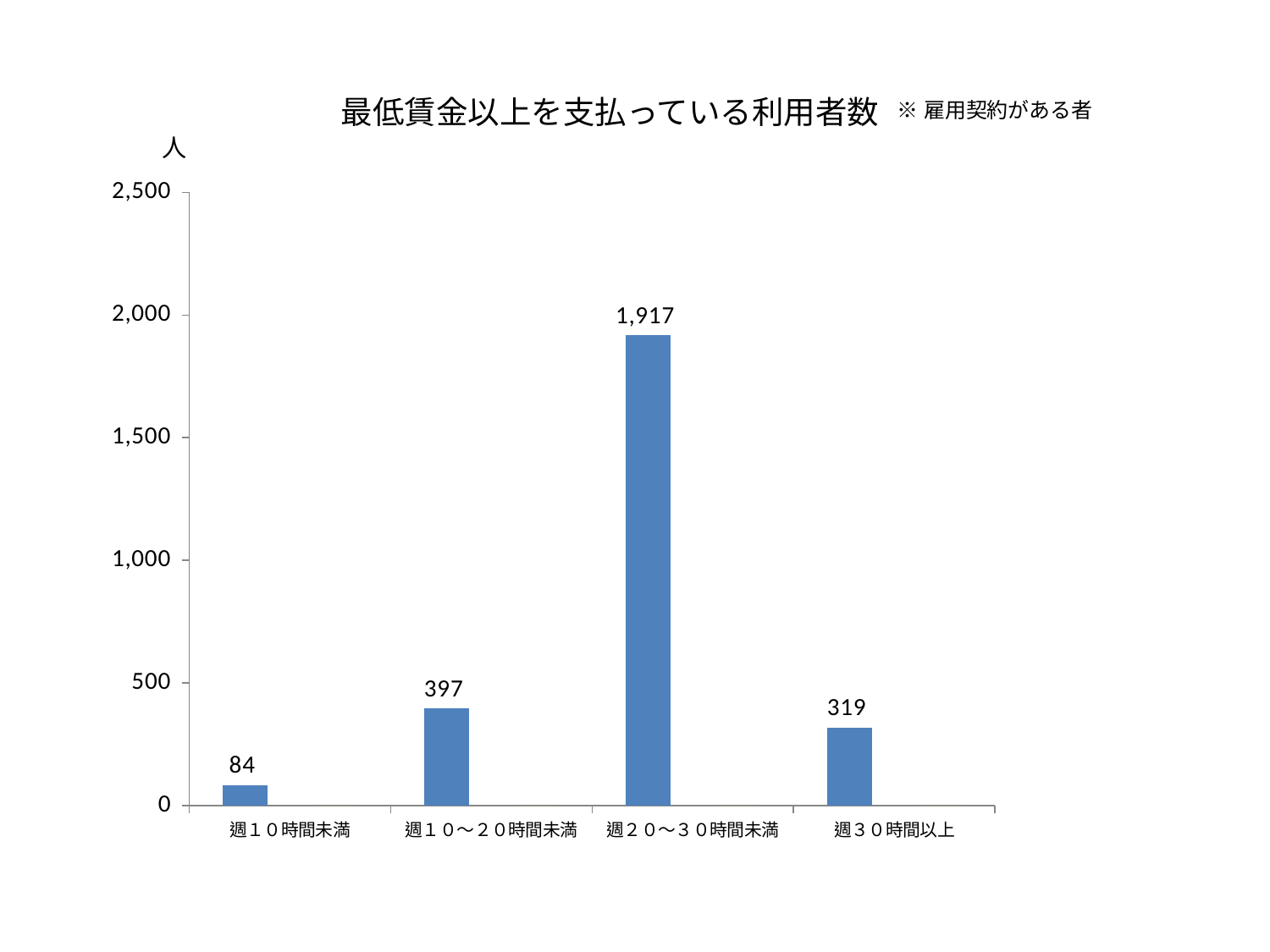
What is the value for 週３０時間以上? 319 Which is larger, the value for 週１０～２０時間未満 or 週３０時間以上? 週１０～２０時間未満 Is the value for 週２０～３０時間未満 greater or less than 1,500? greater Which category has the highest value? 週２０～３０時間未満 What kind of chart is shown on the slide? bar chart What is the difference between the values for 週１０～２０時間未満 and 週３０時間以上? 78 What is the value for 週１０～２０時間未満? 397 What is the value for 週２０～３０時間未満? 1,917 Which category has the lowest value? 週１０時間未満 How many categories are shown on the x axis? 4 What is the difference between the values for 週２０～３０時間未満 and 週１０～２０時間未満? 1,520 What is the value for 週１０時間未満? 84